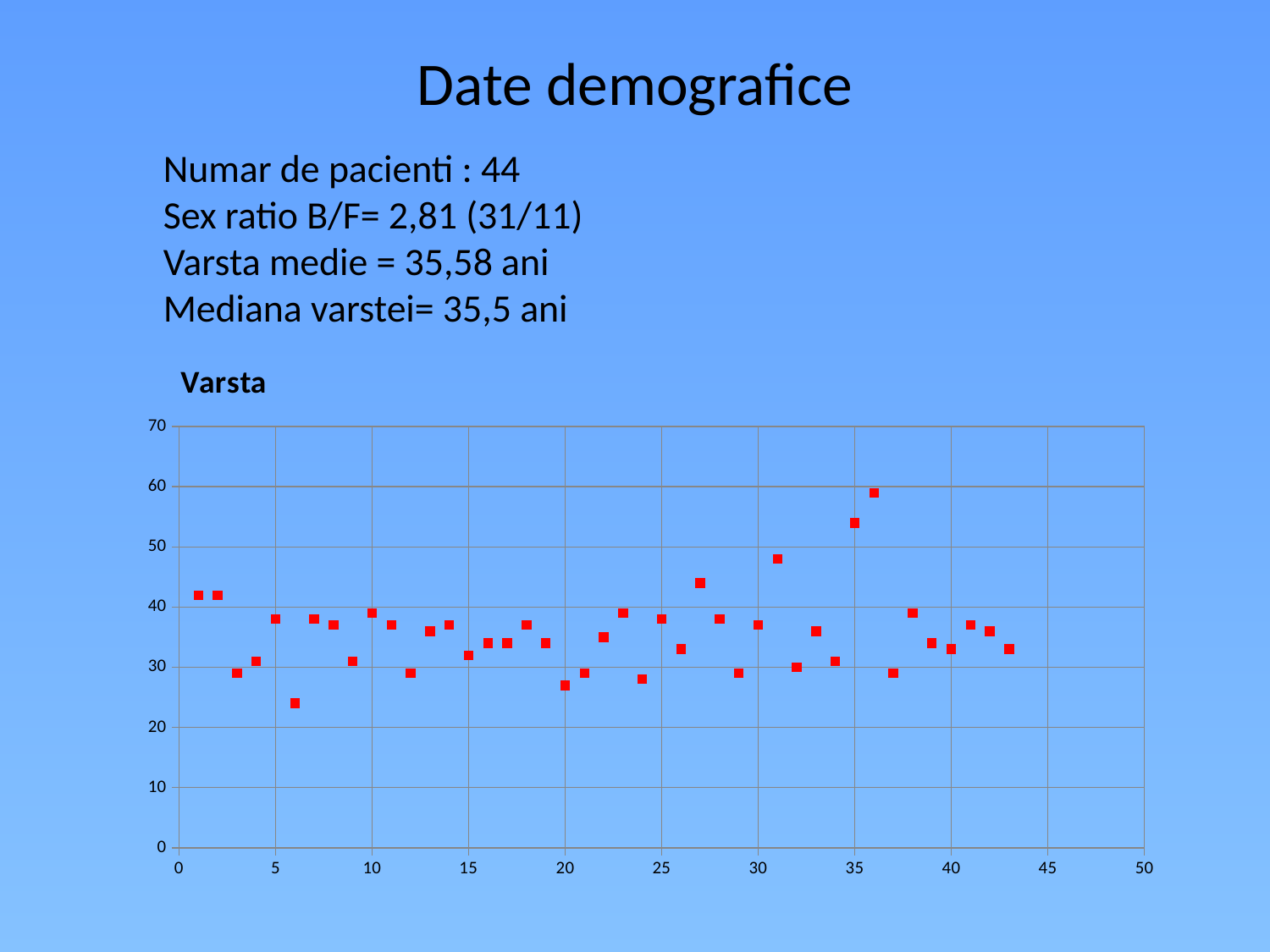
What colour are the markers in the "Varsta" chart? red In the "Varsta" chart, which point is higher: the one at x = 27 or the one at x = 6? x = 27 In the "Varsta" chart, at which x value is the lowest point plotted? 6 In the "Varsta" chart, is the value at x = 20 greater or less than 30? less What is the title of the chart on the slide? Varsta In the "Varsta" chart, is the value at x = 35 greater or less than 50? greater What kind of chart is shown under the title "Varsta"? scatter chart In the "Varsta" chart, is the value at x = 36 greater or less than 50? greater In the "Varsta" chart, at which x value is the highest point plotted? 36 In the "Varsta" chart, which point is higher: the one at x = 36 or the one at x = 35? x = 36